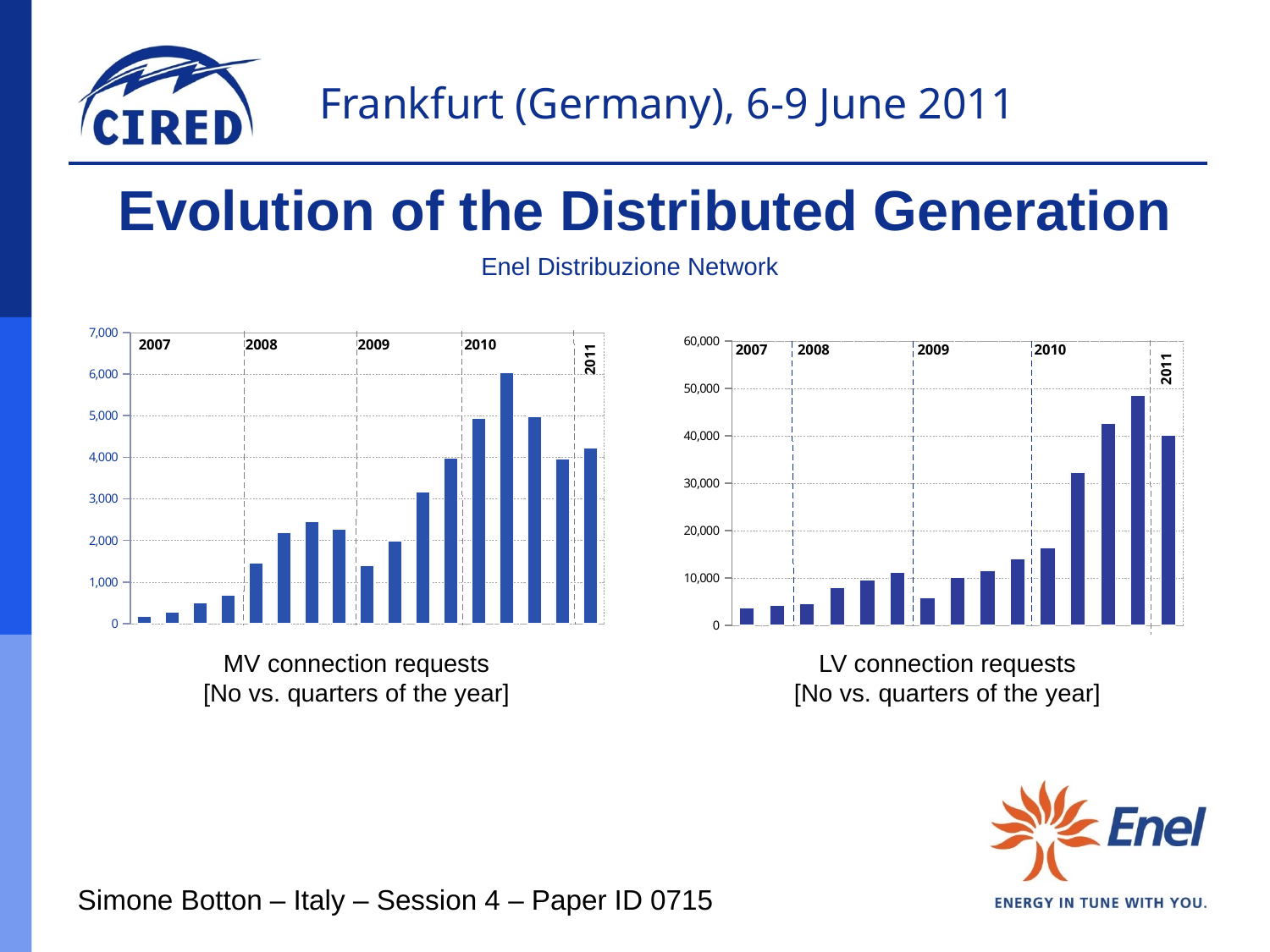
In the LV connection requests chart, is the first bar of 2007 greater or less than 10,000? less What kind of chart is the LV connection requests chart? bar chart What is the highest value shown on the y axis of the LV connection requests chart? 60,000 In the MV connection requests chart, is the tallest bar greater or less than 5,000? greater How many bars are plotted in the MV connection requests chart? 17 In the LV connection requests chart, is the tallest bar greater or less than 40,000? greater How many bars are plotted in the LV connection requests chart? 15 In the LV connection requests chart, which year contains the tallest bar? 2010 In the MV connection requests chart, which year contains the tallest bar? 2010 What kind of chart is the MV connection requests chart? bar chart In the LV connection requests chart, do the values generally rise or fall from 2007 to 2010? rise